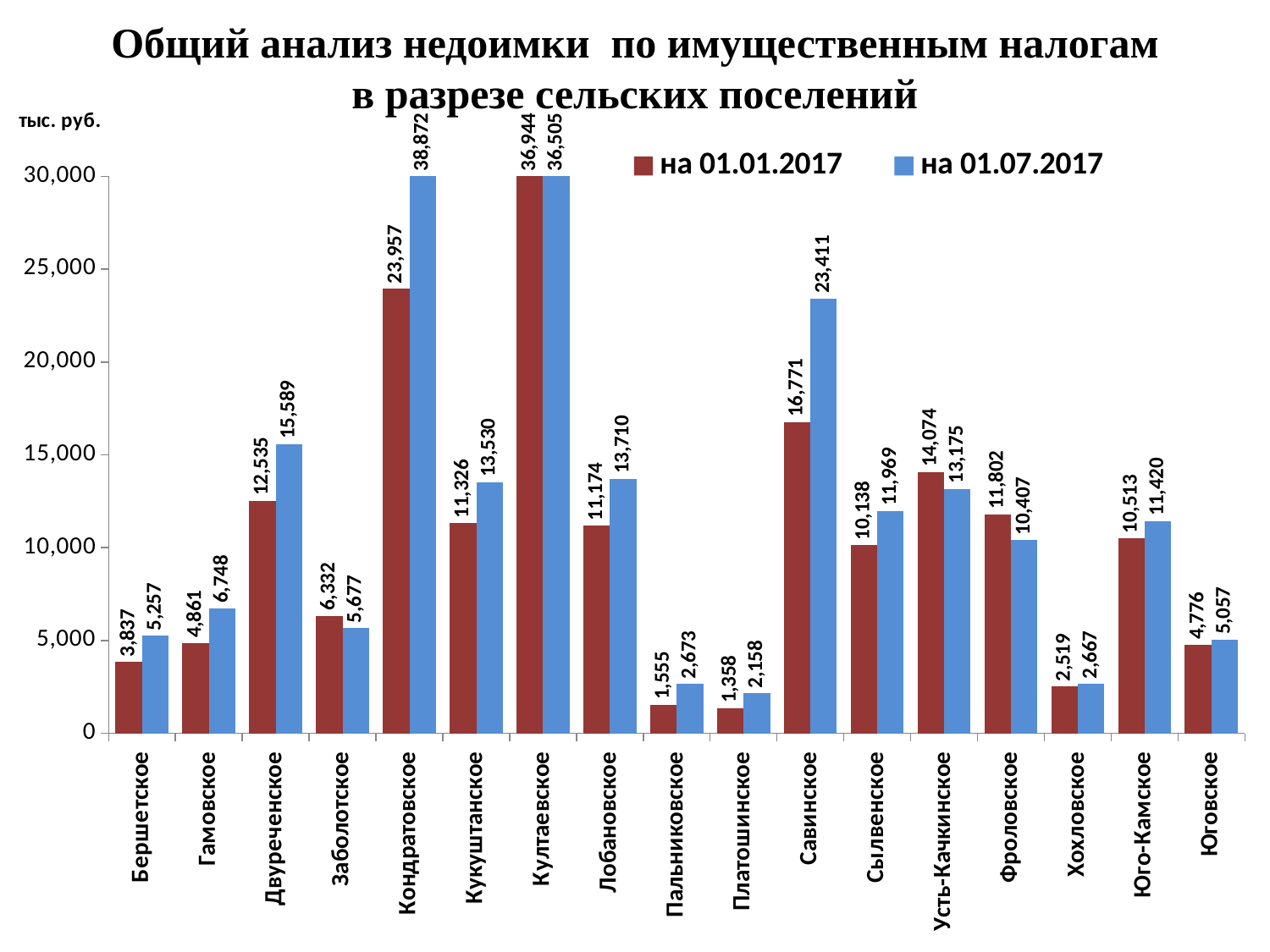
For Фроловское, which is larger: the value на 01.01.2017 or на 01.07.2017? на 01.01.2017 How many settlements are shown on the x axis? 17 What is the value for Кондратовское in the series на 01.07.2017? 38,872 Which settlement has the highest value in the series на 01.01.2017? Култаевское How many series does the legend list? 2 What is the difference between the на 01.07.2017 and на 01.01.2017 values for Кондратовское? 14,915 What type of chart is shown on the slide? Bar chart Which settlement has the lowest value in the series на 01.01.2017? Платошинское Which settlement has the highest value in the series на 01.07.2017? Кондратовское What is the value for Хохловское in the series на 01.07.2017? 2,667 What is the difference between the на 01.07.2017 and на 01.01.2017 values for Савинское? 6,640 What is the value for Савинское in the series на 01.01.2017? 16,771